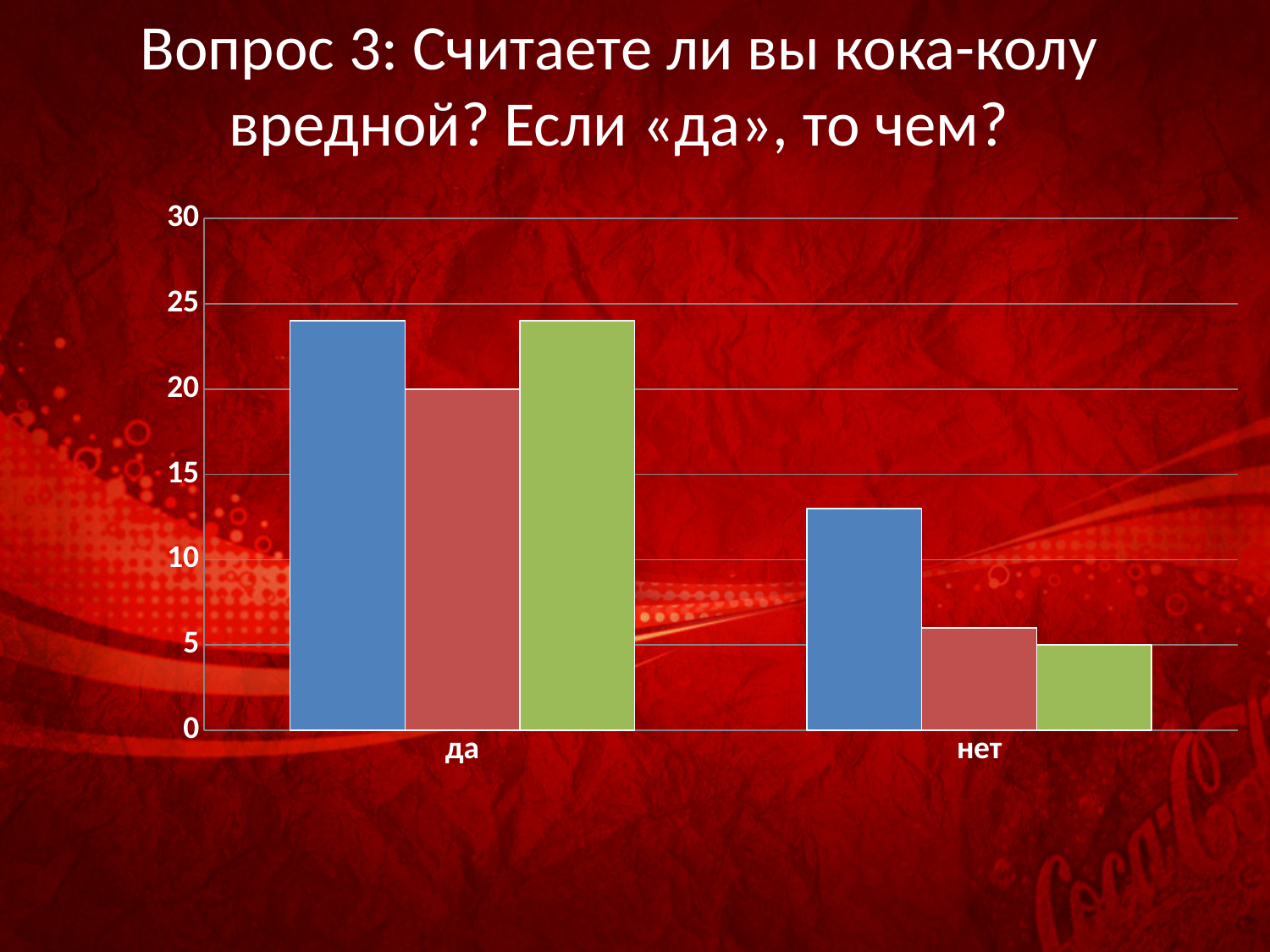
What kind of chart is shown on the slide? bar chart Which category has the larger blue bar, "да" or "нет"? да What are the category labels on the x axis of the chart? да, нет Is the value of the red bar for "нет" greater or less than 10? less Within the category "да", which coloured bar is the lowest? red Is the value of the blue bar for "нет" greater or less than 10? greater How many bars are shown for each category in the chart? 3 Is the value of the green bar for "да" greater or less than 20? greater How many categories are shown on the x axis of the chart? 2 What is the value of the red bar for the category "да"? 20